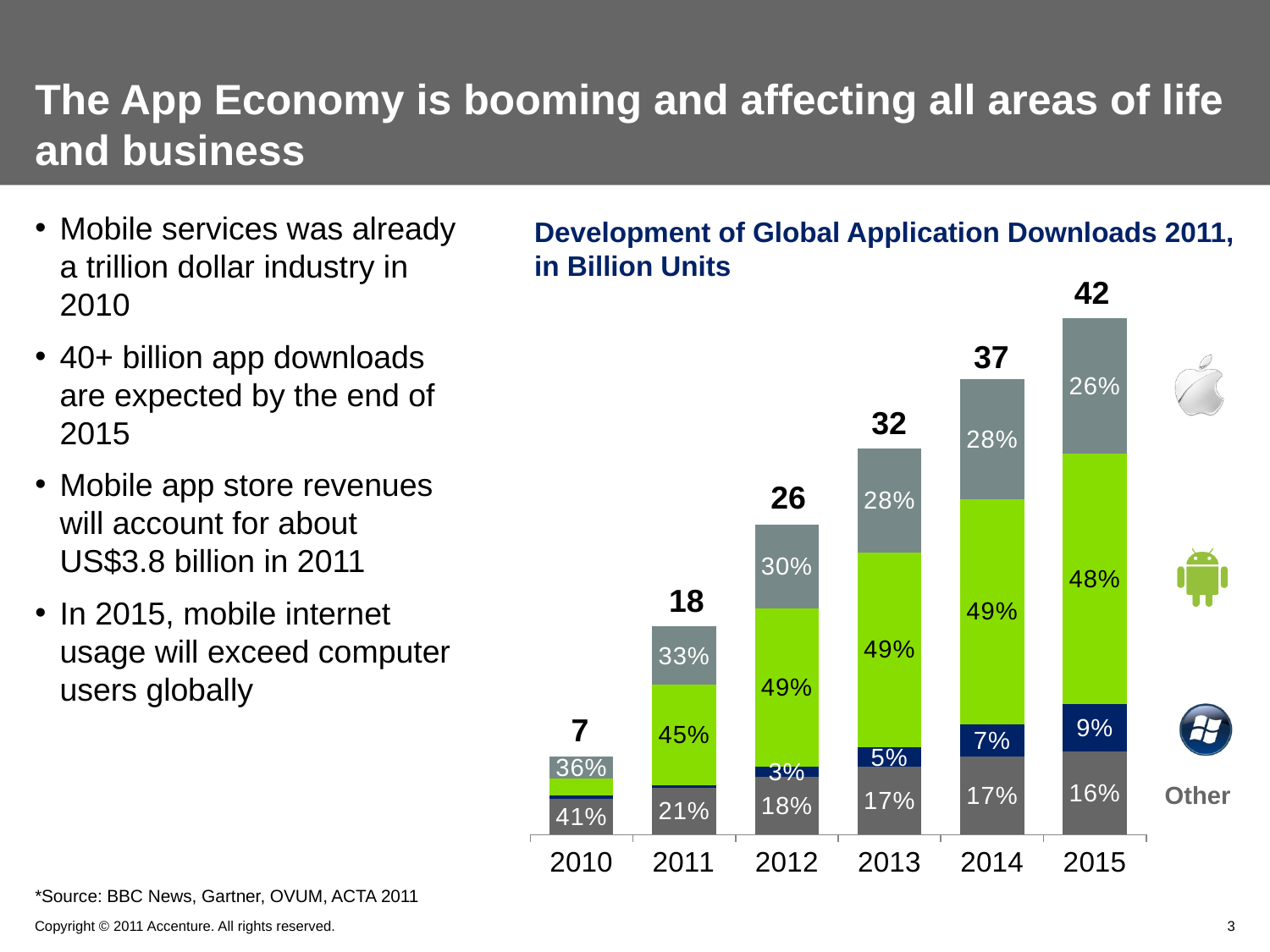
How many years are shown on the x axis of the chart? 6 Do the total application downloads rise or fall from 2010 to 2015? rise What is the total value shown above the bar for 2010? 7 What percentage does the top grey (Apple) segment account for in 2012? 30% What percentage does the dark blue (Windows) segment account for in 2015? 9% What is the total value shown above the bar for 2015? 42 Which is larger, the total for 2012 or the total for 2013? 2013 What is the difference between the total for 2015 and the total for 2014? 5 What percentage does the 'Other' segment (bottom, dark grey) account for in 2011? 21% What percentage does the green (Android) segment account for in 2014? 49% Which year has the lowest total of global application downloads? 2010 Which year has the highest total of global application downloads? 2015